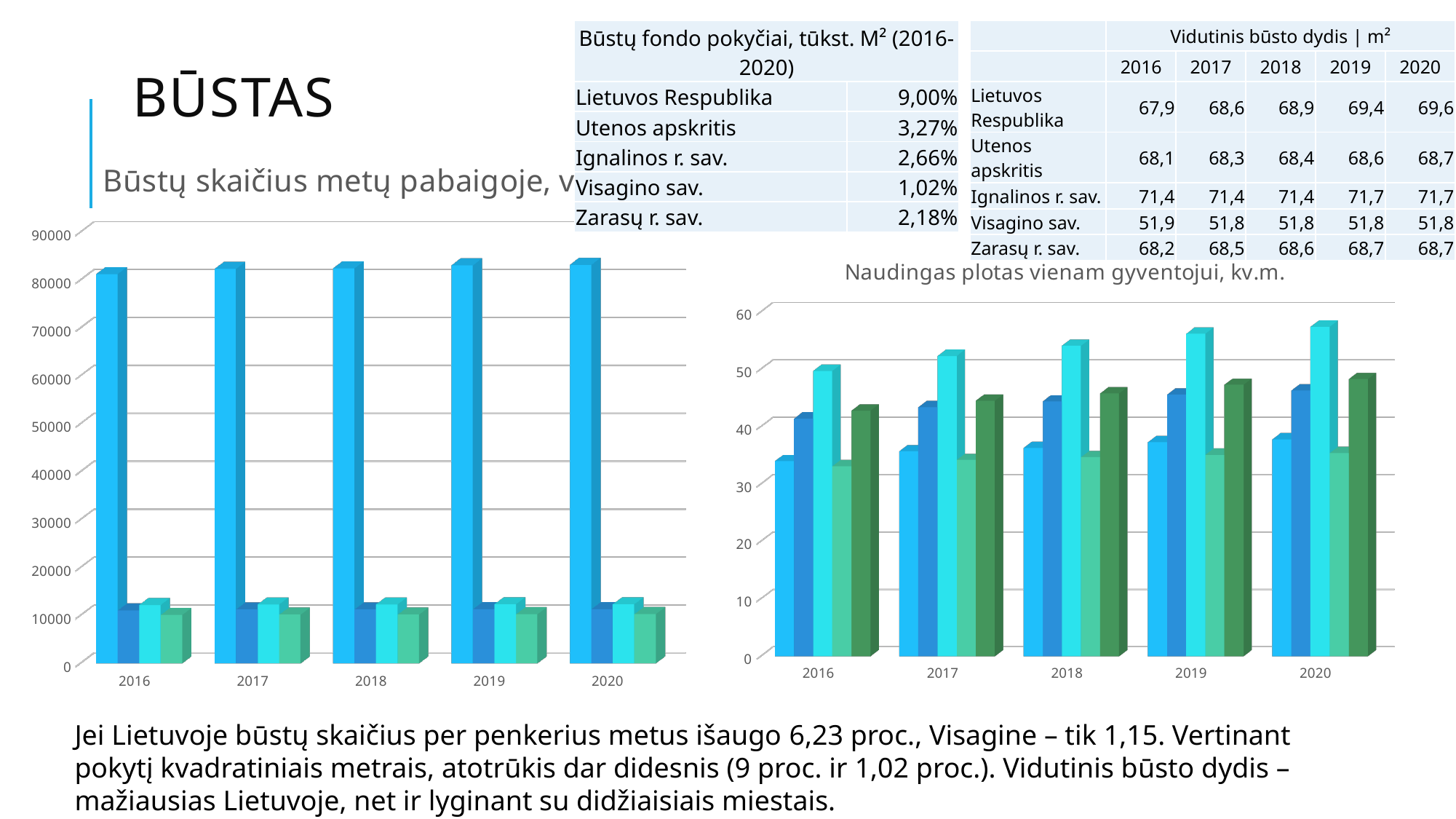
In the chart titled 'Naudingas plotas vienam gyventojui, kv.m.', in which year is the cyan bar tallest? 2020 How many years are shown on the x axis of the chart titled 'Naudingas plotas vienam gyventojui, kv.m.'? 5 In the chart titled 'Naudingas plotas vienam gyventojui, kv.m.', do the cyan bars rise or fall from 2016 to 2020? rise In the chart titled 'Naudingas plotas vienam gyventojui, kv.m.', is the light green bar for 2018 greater or less than 40? less What kind of chart is the chart titled 'Naudingas plotas vienam gyventojui, kv.m.'? bar chart In the chart on the left of the slide, is the dark blue bar for 2020 greater or less than 20000? less What kind of chart is the chart on the left of the slide (Būstų skaičius metų pabaigoje)? bar chart In the chart titled 'Naudingas plotas vienam gyventojui, kv.m.', for 2020, which is larger: the cyan bar or the dark green bar? the cyan bar How many years are shown on the x axis of the chart on the left of the slide? 5 In the chart on the left of the slide, is the tallest bar for 2016 greater or less than 70000? greater How many bars are plotted for each year in the chart titled 'Naudingas plotas vienam gyventojui, kv.m.'? 5